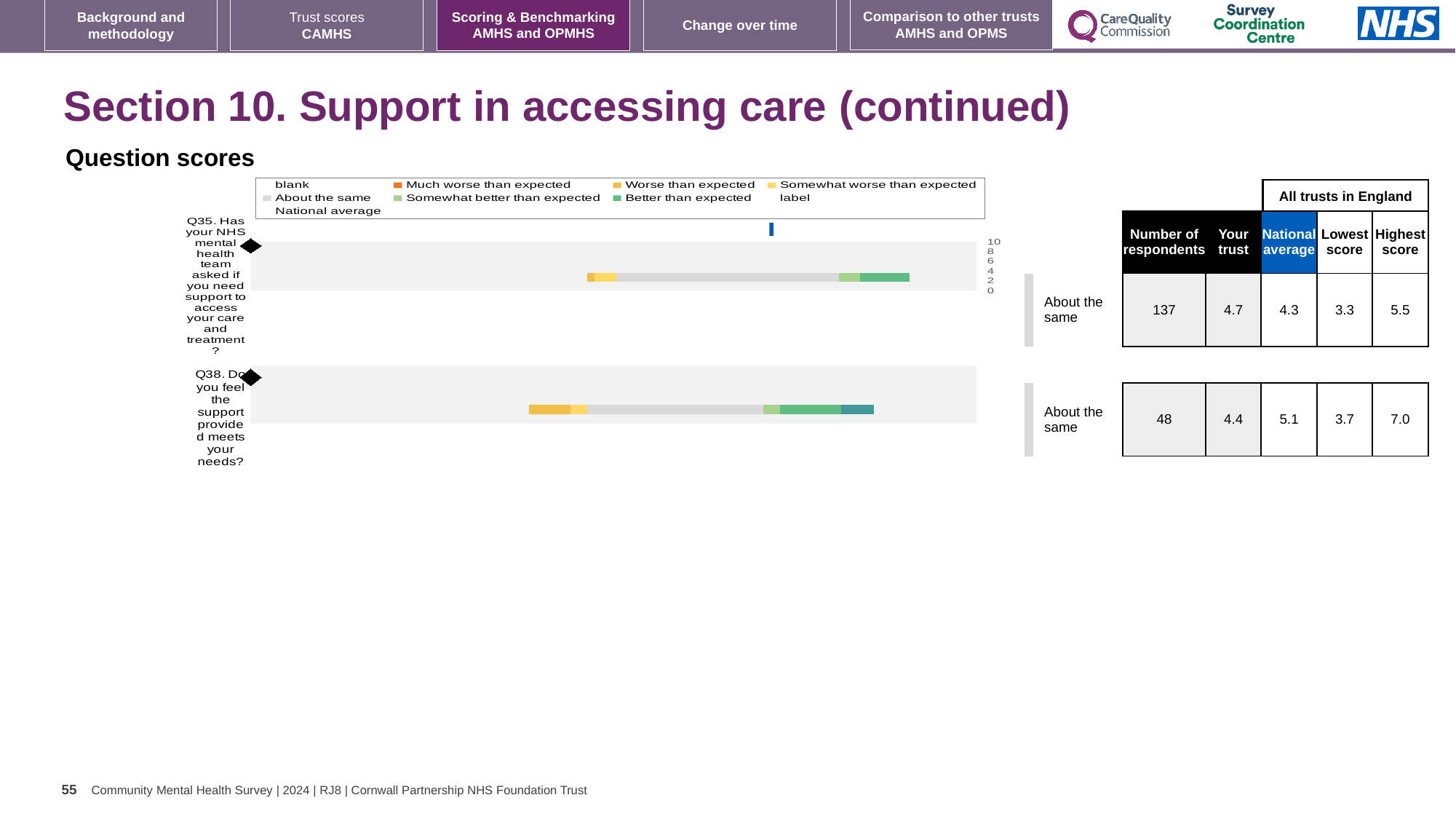
Which question has more respondents, Q35 or Q38? Q35 Which legend entry is shown in grey in the chart? About the same What is the highest score among all trusts in England for Q38? 7.0 Which legend entry is shown in dark orange in the chart? Much worse than expected Which question has the higher 'Your trust' score, Q35 or Q38? Q35 What is the 'Your trust' score for Q38? 4.4 What is the difference between the highest score and the lowest score for Q38? 3.3 What benchmark category is shown next to the bar for Q38? About the same What is the national average for Q35? 4.3 How many questions are plotted as bars in the chart? 2 What is the number of respondents for Q35? 137 What kind of chart is shown under 'Question scores'? bar chart